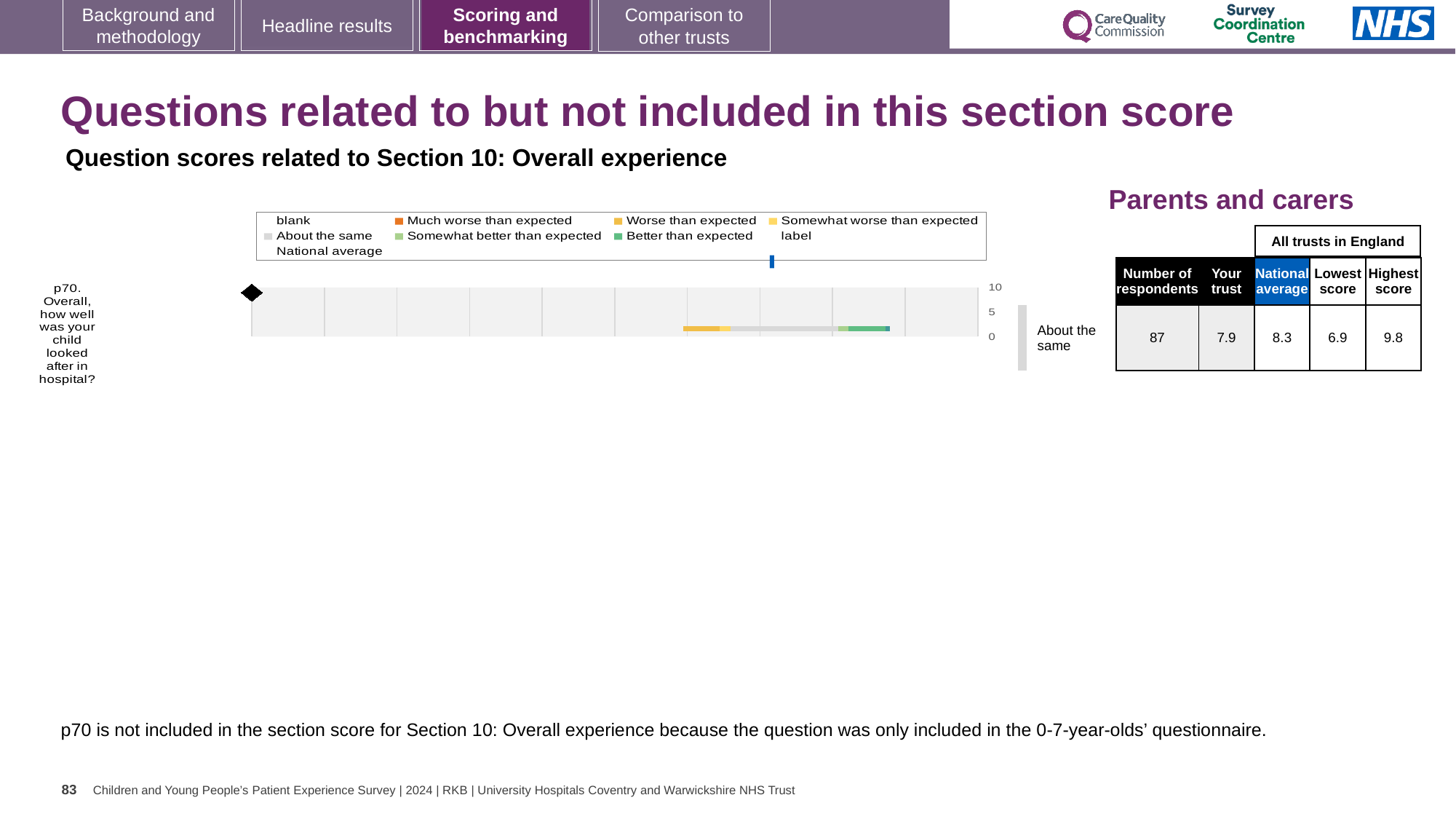
In the table next to the chart, what is the lowest score among all trusts in England for p70? 6.9 In the table next to the chart, what is the national average score for p70? 8.3 How many questions (categories) are plotted in the chart? 1 Which is larger for p70, the 'Your trust' score or the national average? National average In the table next to the chart, what is the highest score among all trusts in England for p70? 9.8 What is the highest value shown on the chart's score axis? 10 In the table next to the chart, how many respondents answered p70? 87 How many entries does the chart legend list? 9 Which benchmark category label is shown to the right of the p70 bar? About the same In the table next to the chart, what is the 'Your trust' score for p70? 7.9 What is the difference between the highest score and the lowest score for p70 in the table? 2.9 What kind of chart is shown for question p70? bar chart